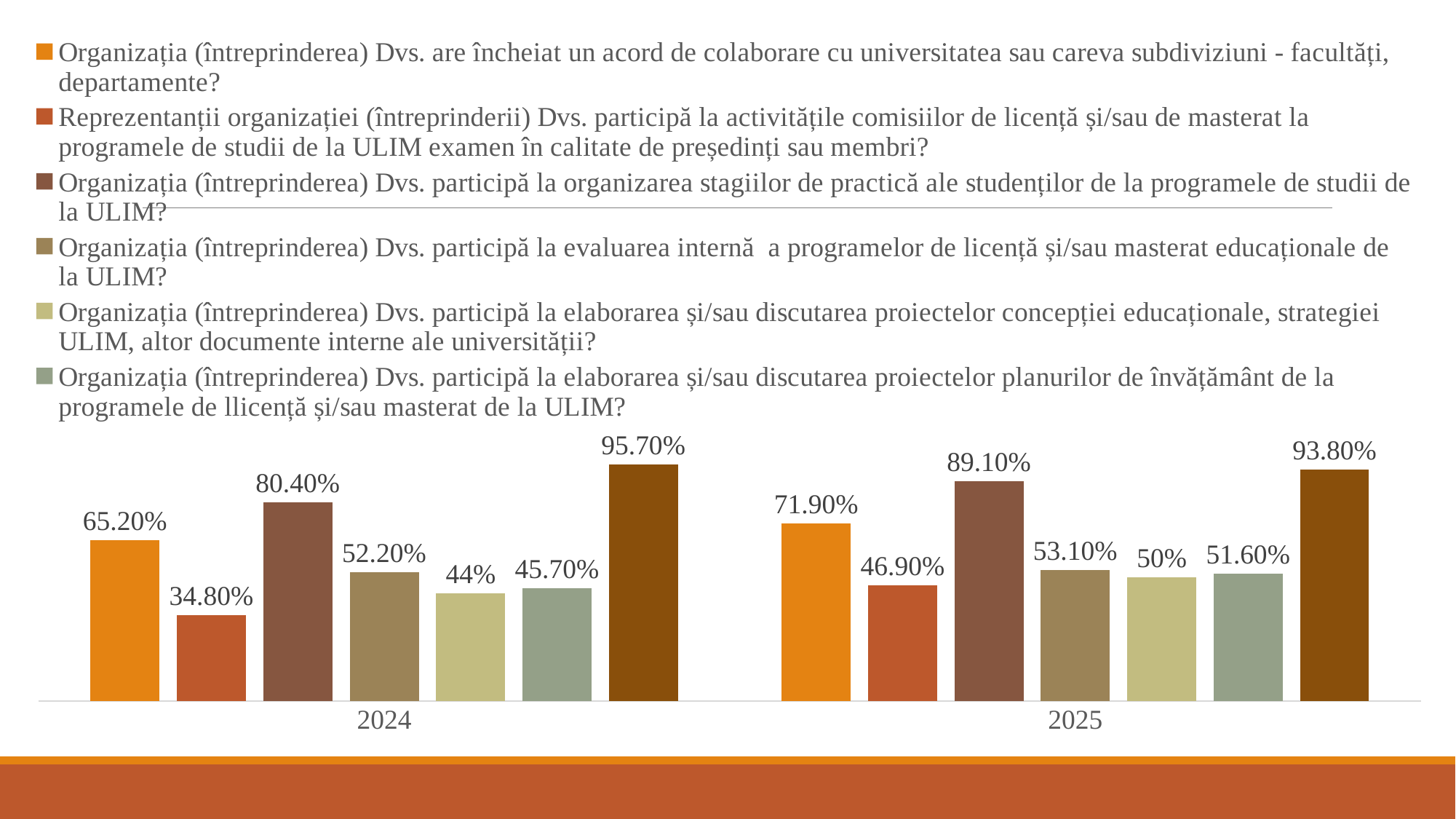
What kind of chart is shown on the slide? Bar chart What is the 2024 value for the series about the organisation having a collaboration agreement with the university (first legend entry, orange)? 65.20% What is the 2025 value for the series about representatives participating in licence/master examination commissions (second legend entry)? 46.90% What is the highest data label shown for the 2024 group? 95.70% What is the 2025 value for the series about participating in the elaboration/discussion of the educational concept and ULIM strategy (fifth legend entry)? 50% Does the value for the collaboration agreement series (first legend entry) rise or fall from 2024 to 2025? Rise How many series does the legend list? 6 Which legend series has the lowest value in 2024? Reprezentanții organizației (întreprinderii) Dvs. participă la activitățile comisiilor de licență și/sau de masterat la programele de studii de la ULIM examen în calitate de președinți sau membri? What is the 2024 value for the series about participating in organising student internships (third legend entry)? 80.40% Which is larger: the 2024 value for the internal evaluation of programmes series (fourth legend entry) or the 2024 value for the curricula plans series (sixth legend entry)? The internal evaluation series (52.20%) How many year categories are shown on the x axis? 2 What is the difference between the 2025 and 2024 values for the series about participating in organising student internships (third legend entry)? 8.70%